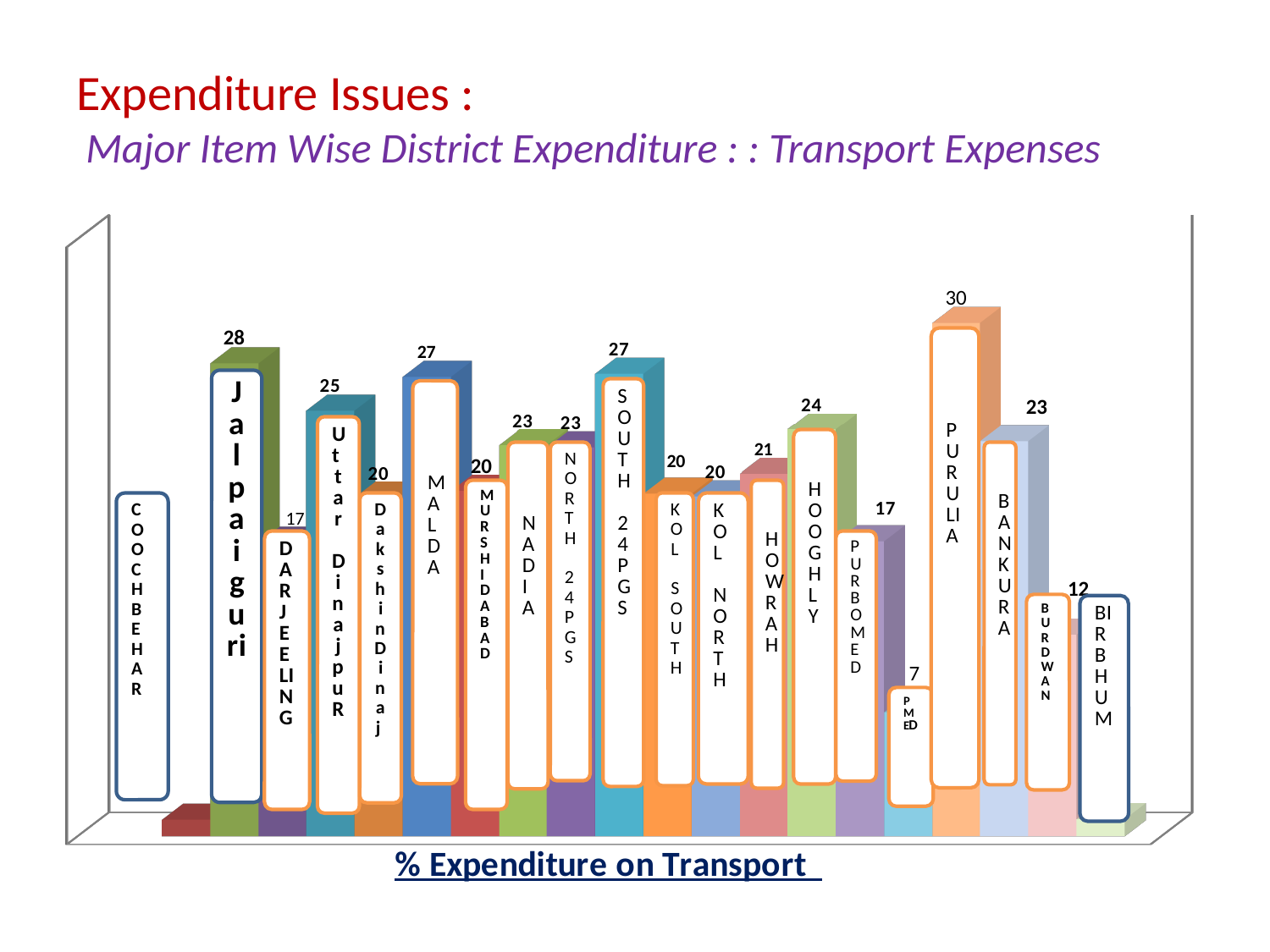
What is the difference between the values for Purulia and Jalpaiguri? 2 What is the axis title shown below the chart? % Expenditure on Transport What is the value for Purulia? 30 What is the value for Burdwan? 12 What is the value for Jalpaiguri? 28 What is the difference between the values for Malda and Burdwan? 15 What kind of chart is shown on the slide? Bar chart What is the value for Hooghly? 24 What is the value for PMED? 7 What is the value for Darjeeling? 17 Which is larger, the value for Uttar Dinajpur or the value for Howrah? Uttar Dinajpur Which district has the highest value? Purulia